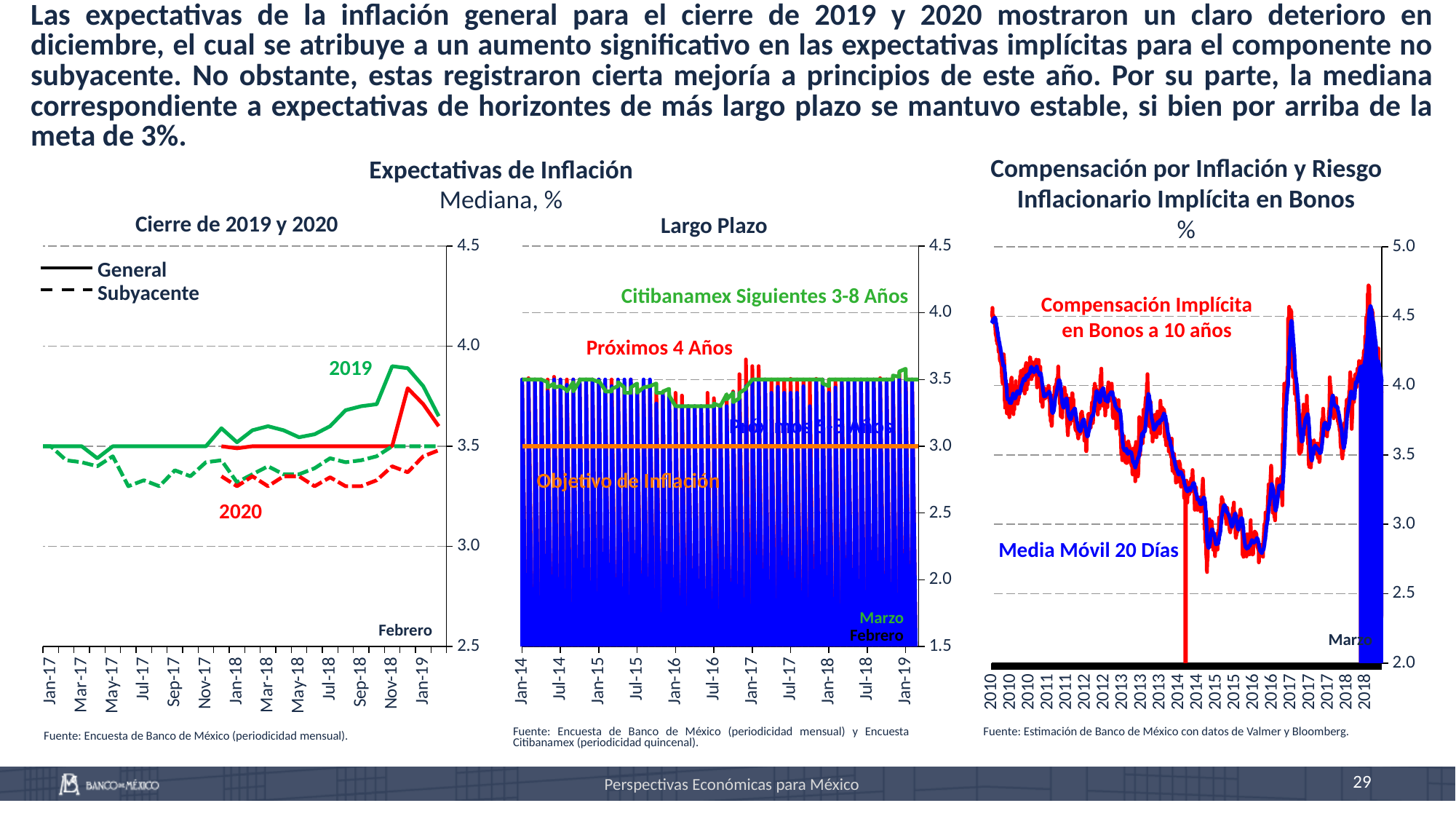
In the 'Compensación por Inflación y Riesgo Inflacionario Implícita en Bonos' chart, what kind of chart is shown? line chart In the 'Largo Plazo' chart, at what value is the 'Objetivo de Inflación' line drawn? 3.0 In the 'Cierre de 2019 y 2020' chart, how many entries does the legend list? 2 In the 'Cierre de 2019 y 2020' chart, what kind of chart is shown? line chart In the 'Cierre de 2019 y 2020' chart, is the value of the 2020 Subyacente line at Jan-18 greater or less than 3.5? less In the 'Cierre de 2019 y 2020' chart, which is higher at Nov-18: the 2019 General line or the 2020 General line? 2019 General What is the unit shown under the title 'Expectativas de Inflación'? Mediana, % In the 'Cierre de 2019 y 2020' chart, which line style represents 'Subyacente'? dashed In the 'Largo Plazo' chart, is the 'Citibanamex Siguientes 3-8 Años' line at Jan-19 greater or less than 3.0? greater In the 'Compensación por Inflación y Riesgo Inflacionario Implícita en Bonos' chart, do the values generally rise or fall from 2010 to 2016? fall In the 'Cierre de 2019 y 2020' chart, is the value of the 2019 General line at Nov-18 greater or less than 3.5? greater